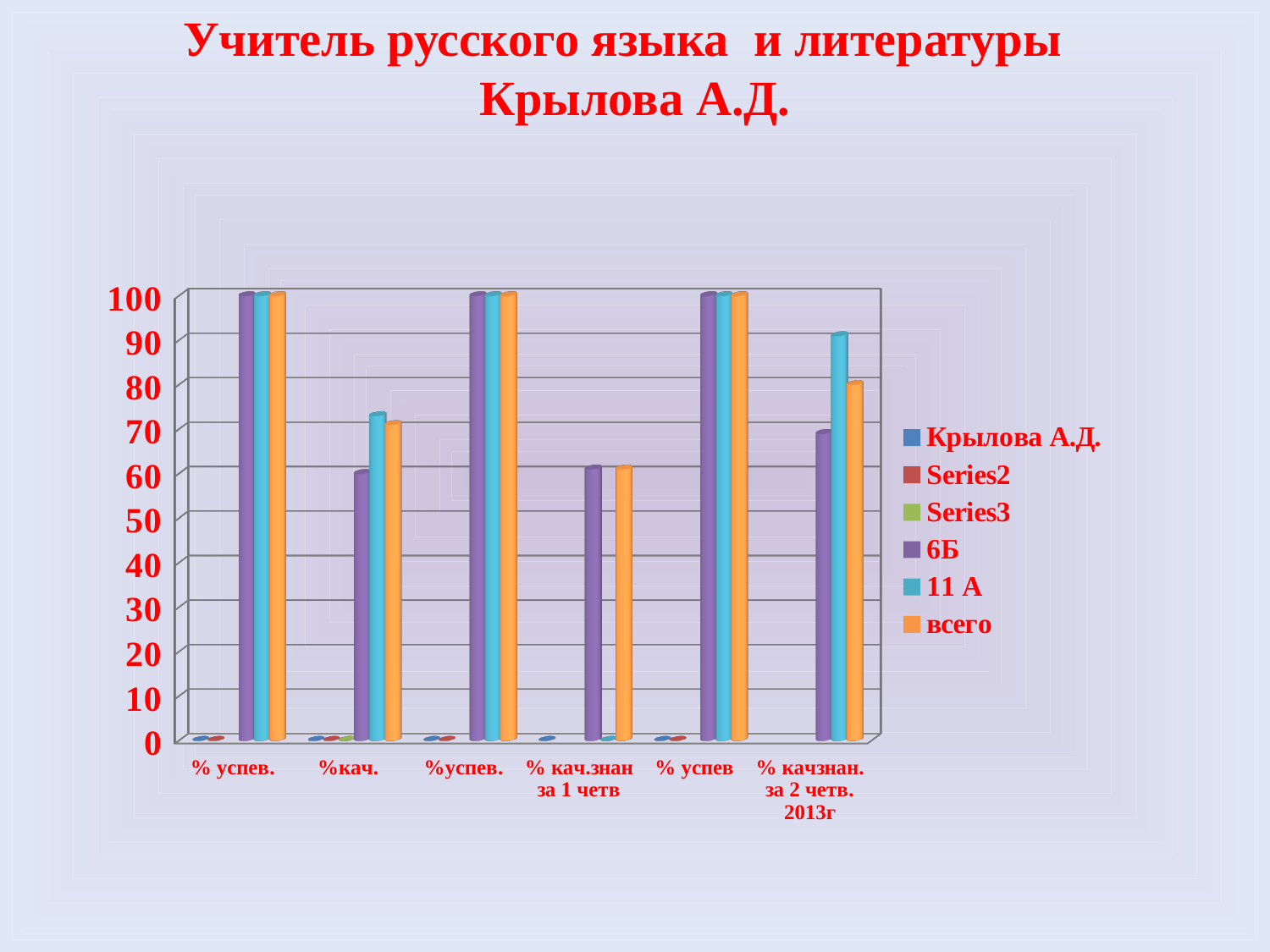
Is the value for 11 А in the "%кач." category greater or less than 60? greater How many series does the legend list? 6 What is the first entry listed in the legend? Крылова А.Д. Is the value for всего in the "% качзнан. за 2 четв. 2013г" category greater or less than 70? greater Which is larger for 6Б: the value in "%кач." or the value in "% качзнан. за 2 четв. 2013г"? % качзнан. за 2 четв. 2013г In the "% качзнан. за 2 четв. 2013г" category, which is larger: the value for 11 А or the value for 6Б? 11 А What is the value for 6Б in the first category, "% успев."? 100 How many categories are shown along the x axis? 6 What kind of chart is shown on the slide? bar chart In the "% качзнан. за 2 четв. 2013г" category, which series has the highest value? 11 А Is the value for 6Б in the "% кач.знан за 1 четв" category greater or less than 70? less What is the value for всего in the fifth category, "% успев"? 100